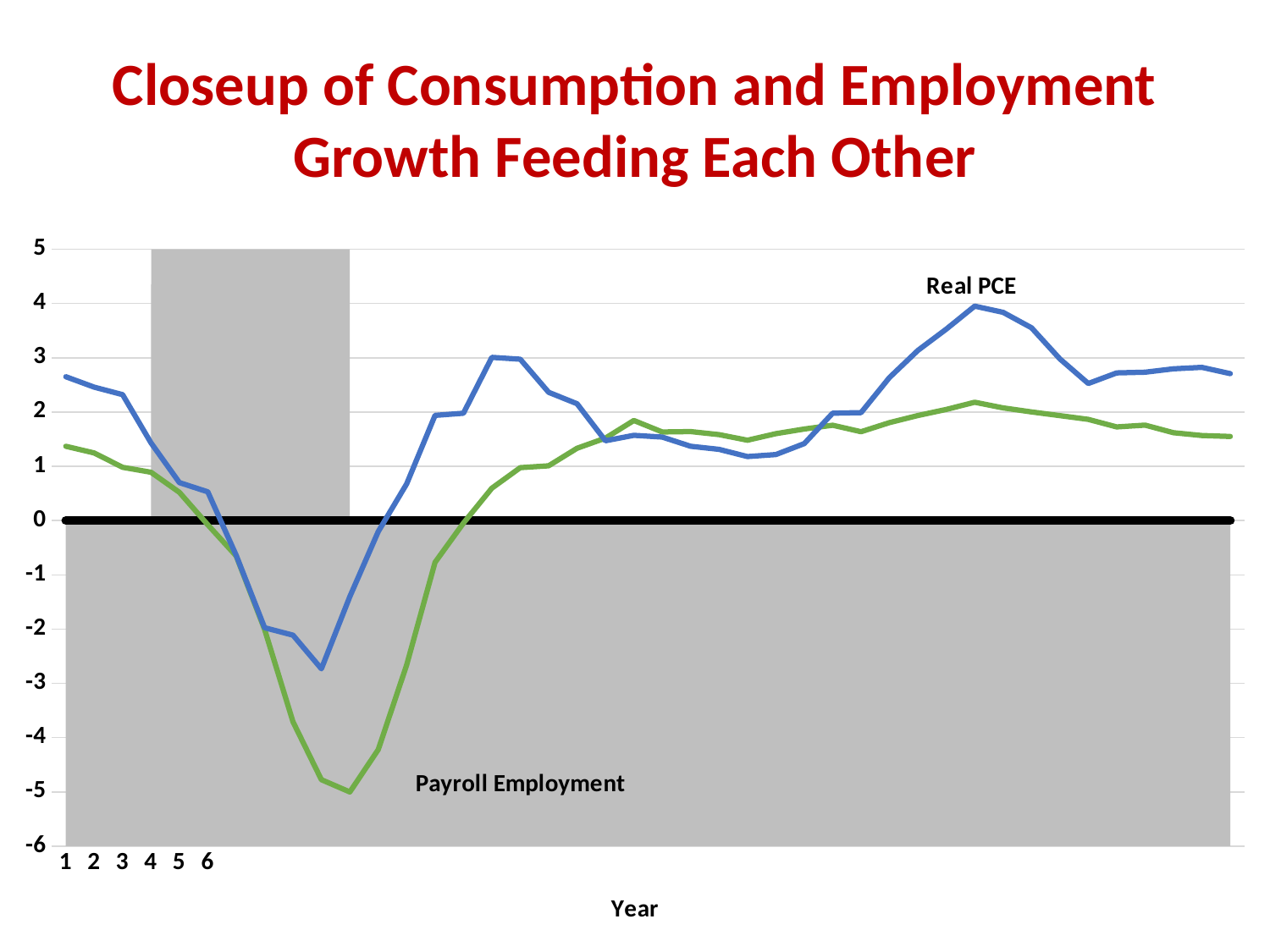
Is the highest value of Real PCE greater or less than 3? greater Is the lowest value of Real PCE greater or less than -2? less Is the value of Real PCE at year 1 greater or less than 2? greater Which series reaches the highest value on the chart? Real PCE Which series reaches the lowest value on the chart? Payroll Employment How many data series are plotted on the chart? 2 What kind of chart is shown on the slide? line chart What is the title of the x axis? Year Does Real PCE rise or fall from year 1 to year 6? fall What are the names of the two series plotted on the chart? Real PCE and Payroll Employment